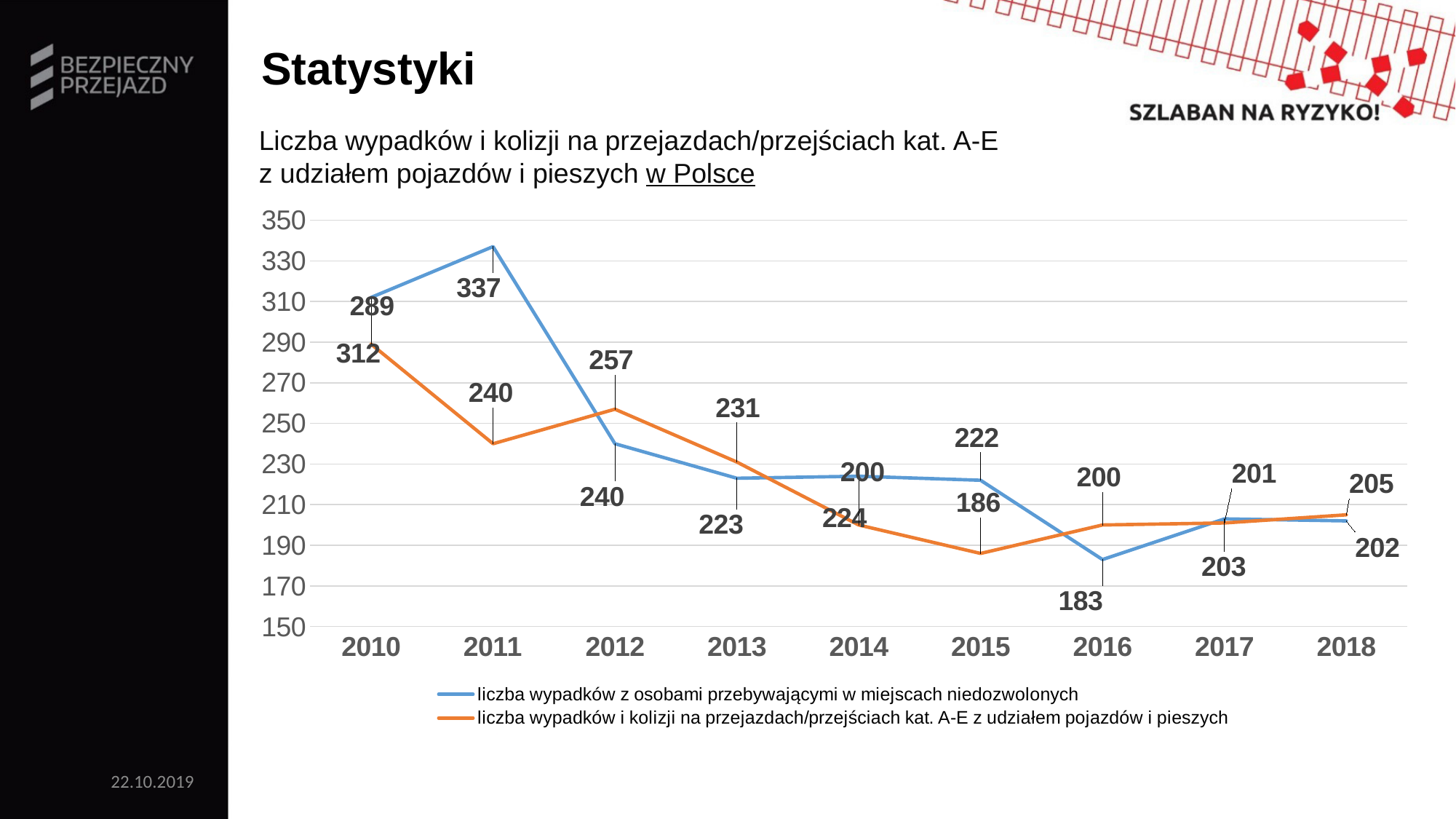
How many series does the legend list? 2 In 2014, which series has the higher value? liczba wypadków z osobami przebywającymi w miejscach niedozwolonych What is the value of the series 'liczba wypadków i kolizji na przejazdach/przejściach kat. A-E z udziałem pojazdów i pieszych' in 2012? 257 What colour is the line for 'liczba wypadków i kolizji na przejazdach/przejściach kat. A-E z udziałem pojazdów i pieszych'? orange In which year does the series 'liczba wypadków z osobami przebywającymi w miejscach niedozwolonych' reach its highest value? 2011 In which year does the series 'liczba wypadków i kolizji na przejazdach/przejściach kat. A-E z udziałem pojazdów i pieszych' reach its lowest value? 2015 What is the value of the series 'liczba wypadków z osobami przebywającymi w miejscach niedozwolonych' in 2011? 337 What kind of chart is shown on the slide? line chart Does the series 'liczba wypadków z osobami przebywającymi w miejscach niedozwolonych' rise or fall between 2011 and 2016? fall By how much did the series 'liczba wypadków z osobami przebywającymi w miejscach niedozwolonych' fall from 2011 to 2012? 97 What is the value of the series 'liczba wypadków z osobami przebywającymi w miejscach niedozwolonych' in 2016? 183 How many years are shown on the x axis? 9